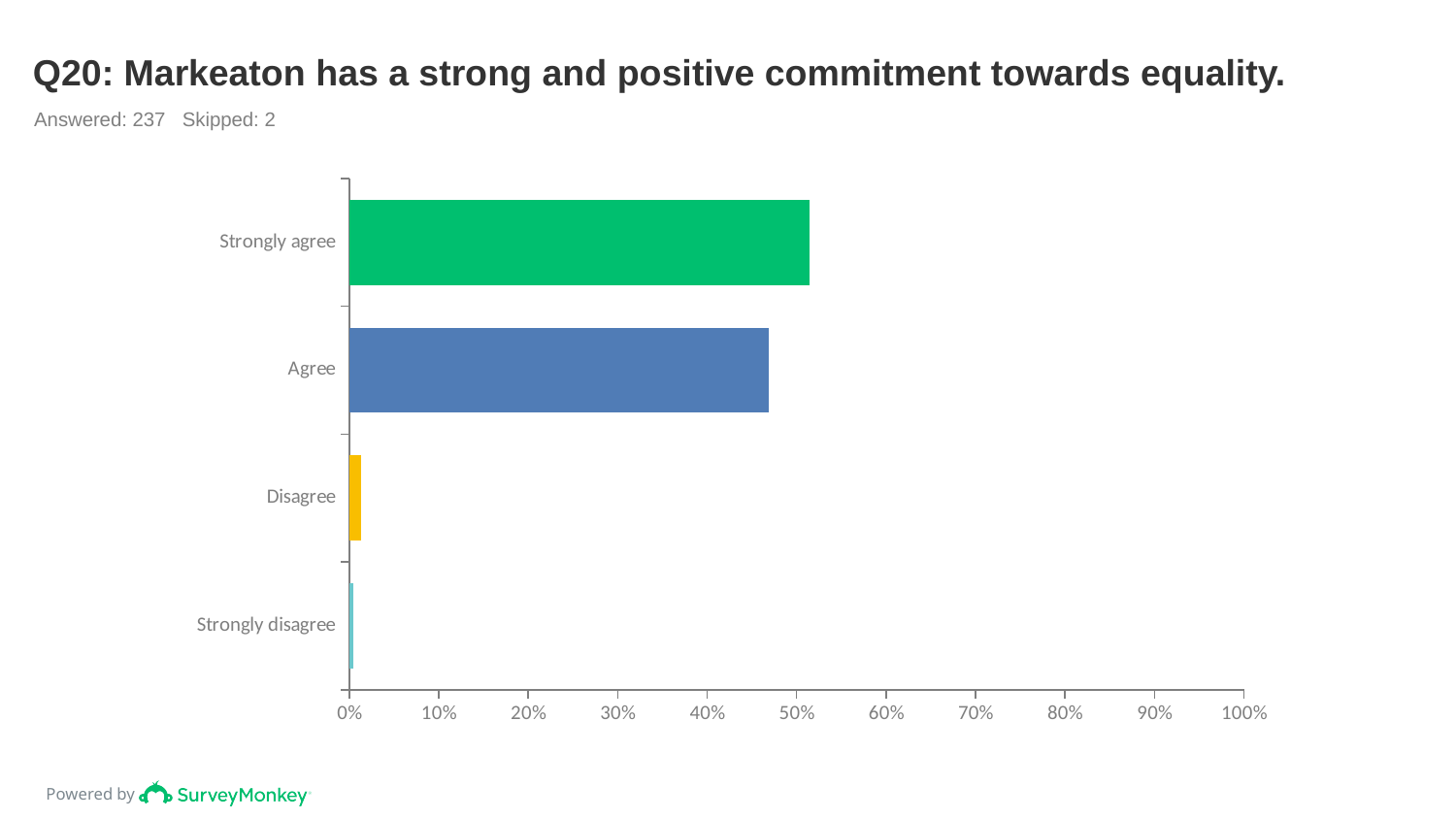
Is the value for Agree greater or less than 50%? less Which response category has the highest value? Strongly agree Which is larger, the value for Strongly agree or the value for Agree? Strongly agree Is the value for Strongly agree greater or less than 40%? greater How many respondents answered the question according to the slide? 237 Which response category has the lowest value? Strongly disagree How many response categories are plotted in the chart? 4 Which is larger, the value for Disagree or the value for Strongly disagree? Disagree What is the title of the chart? Q20: Markeaton has a strong and positive commitment towards equality. What kind of chart is shown on the slide? Bar chart Is the value for Disagree greater or less than 10%? less